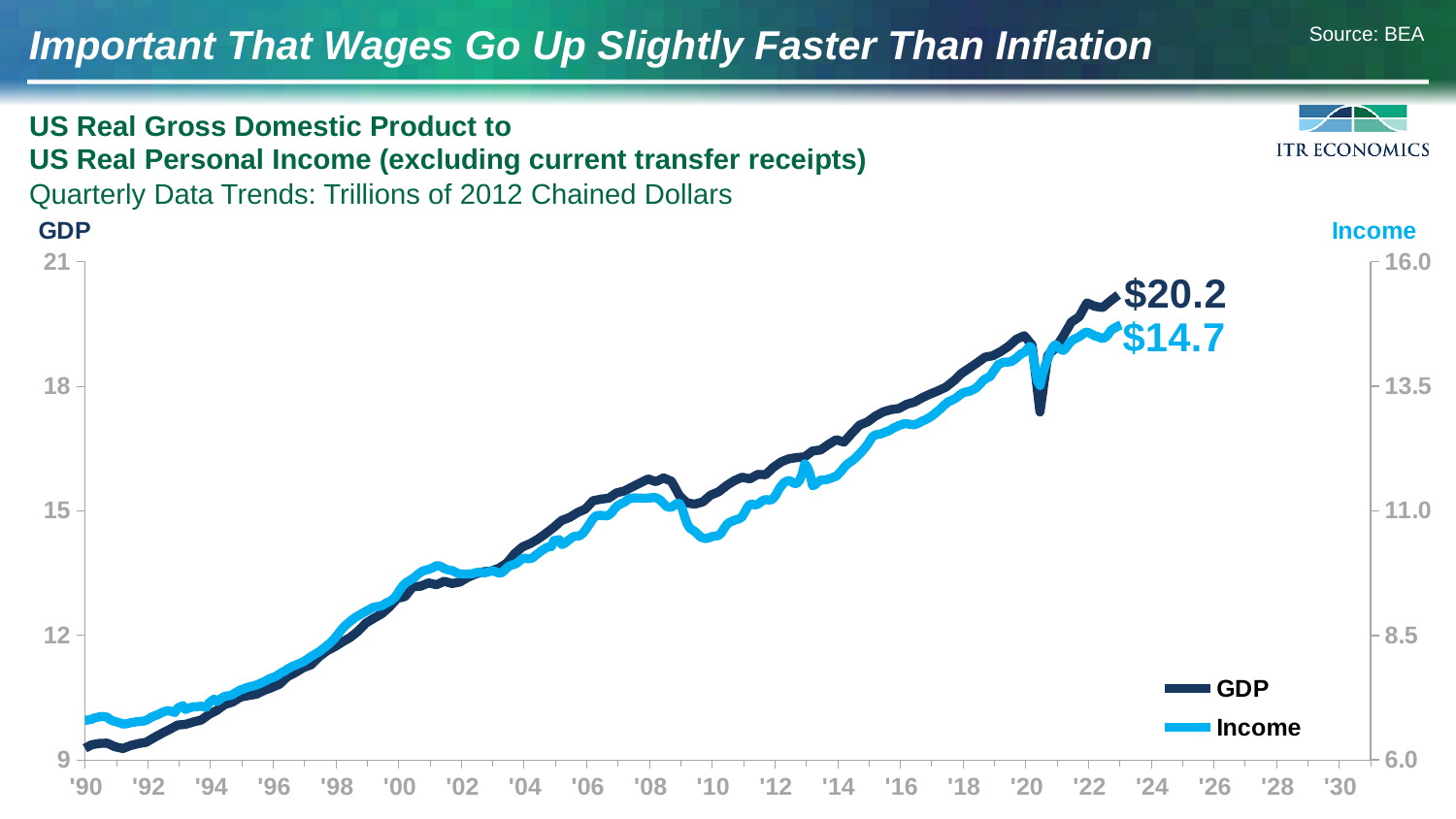
Which series is drawn in dark navy? GDP What type of chart is shown on the slide? line chart Does the Income line generally rise or fall from '90 to '22? rise Is the Income value in '10 greater or less than 11.0 on the right axis? less What unit does the chart subtitle say the data is in? Trillions of 2012 Chained Dollars Is the GDP value in '90 greater or less than 12 on the left axis? less Does the GDP line generally rise or fall from '90 to '22? rise How many series does the chart's legend list? 2 Is the GDP value in '08 greater or less than 15 on the left axis? greater What is the latest labeled value for GDP on the chart? $20.2 What is the latest labeled value for Income on the chart? $14.7